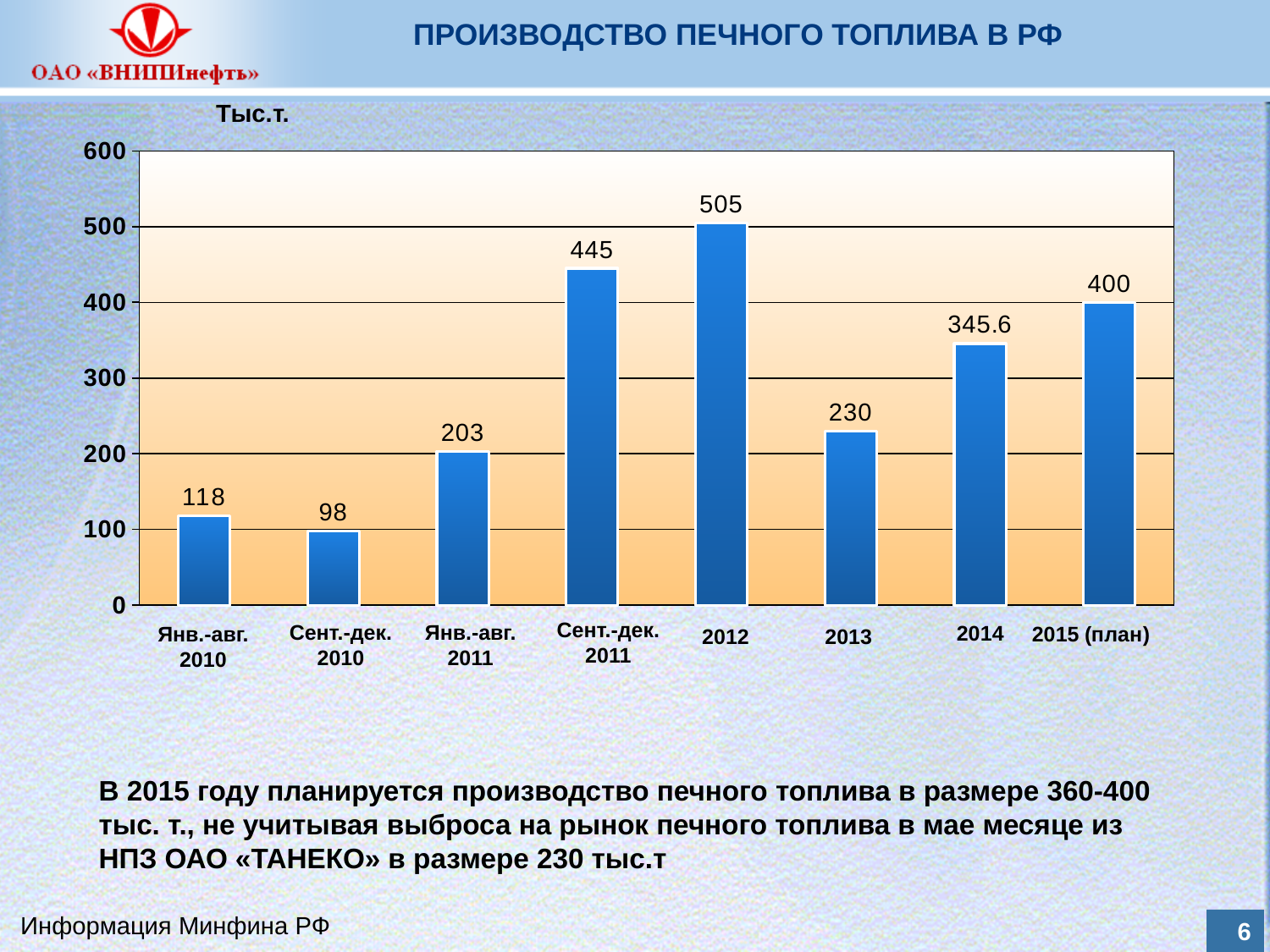
What kind of chart is shown on the slide? bar chart What unit is shown on the y axis label? Тыс.т. What is the value for 2014? 345.6 What is the difference between the values for Янв.-авг. 2011 and Янв.-авг. 2010? 85 What is the value for Сент.-дек. 2010? 98 How many categories are shown on the x axis? 8 Which is larger, the value for Сент.-дек. 2011 or the value for 2015 (план)? Сент.-дек. 2011 What is the value for 2012? 505 Which category has the highest value? 2012 What is the title of the chart? ПРОИЗВОДСТВО ПЕЧНОГО ТОПЛИВА В РФ What is the difference between the values for 2012 and 2013? 275 Which category has the lowest value? Сент.-дек. 2010